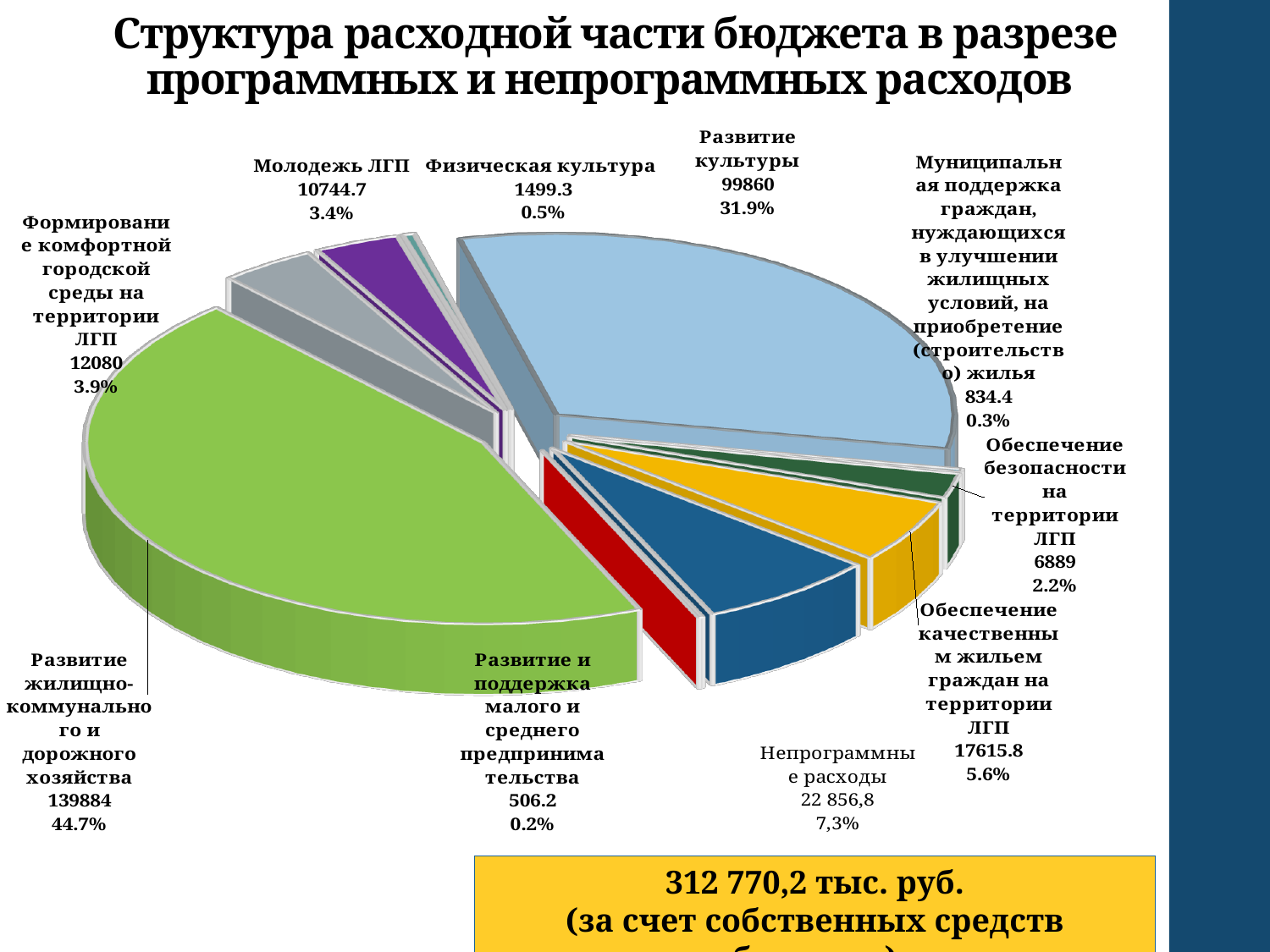
What kind of chart is shown on the slide? pie chart What share of the pie does Развитие жилищно-коммунального и дорожного хозяйства represent? 44.7% How many categories are shown in the pie chart? 10 Which is larger: the value for Обеспечение безопасности на территории ЛГП or the value for Обеспечение качественным жильем граждан на территории ЛГП? Обеспечение качественным жильем граждан на территории ЛГП Which category has the smallest share of the pie? Развитие и поддержка малого и среднего предпринимательства What percentage is shown for Непрограммные расходы? 7,3% What value is shown for Физическая культура? 1499.3 What total amount is shown in the yellow box below the chart? 312 770,2 тыс. руб. What value is shown for Молодежь ЛГП? 10744.7 What is the difference in percentage points between Развитие жилищно-коммунального и дорожного хозяйства (44.7%) and Развитие культуры (31.9%)? 12.8 Which category has the largest share of the pie? Развитие жилищно-коммунального и дорожного хозяйства What value is shown for Развитие культуры? 99860